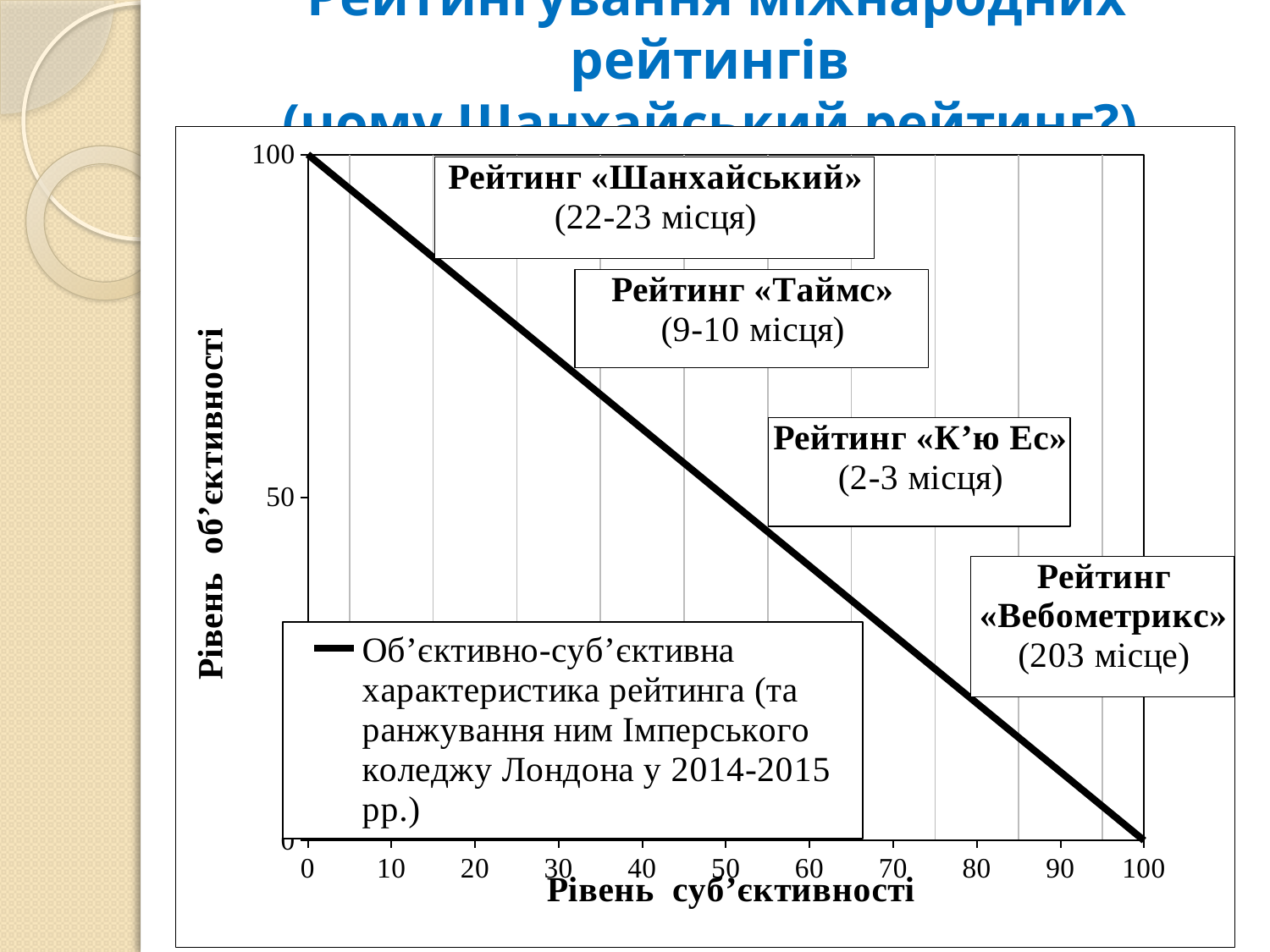
Which is larger: the value of Рівень об'єктивності at Рівень суб'єктивності = 10 or at Рівень суб'єктивності = 90? at 10 How many tick labels are shown on the x axis? 11 Is the value of Рівень об'єктивності at Рівень суб'єктивності = 20 greater or less than 50? greater According to the annotation on the chart, what place does the «Вебометрикс» rating give? 203 місце What kind of chart is shown on the slide? line chart What is the label of the y axis? Рівень об'єктивності Does the plotted line rise or fall as the level of subjectivity (Рівень суб'єктивності) increases along the x axis? fall How many series does the chart legend list? 1 What is the value of Рівень об'єктивності when Рівень суб'єктивності is 100? 0 What is the label of the x axis? Рівень суб'єктивності What is the value of Рівень об'єктивності when Рівень суб'єктивності is 0? 100 Is the value of Рівень об'єктивності at Рівень суб'єктивності = 80 greater or less than 50? less